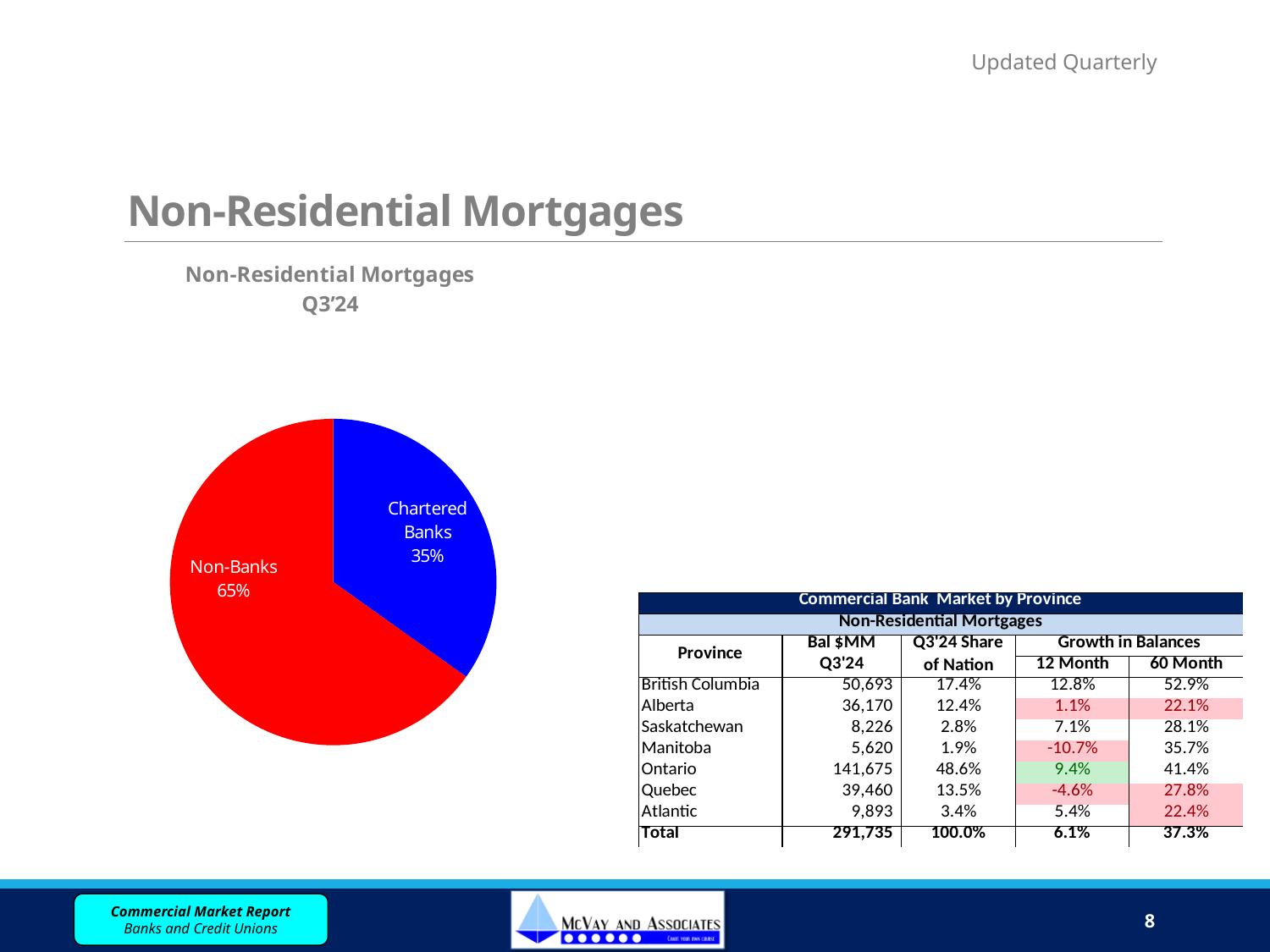
Which slice of the pie chart is the largest? Non-Banks How many slices does the pie chart have? 2 Is the Chartered Banks share of the pie chart greater or less than 50%? less What colour is the Non-Banks slice of the pie chart? red What kind of chart is shown on the slide? pie chart What is the difference in percentage points between the Non-Banks and Chartered Banks slices? 30 What share of the pie chart is Non-Banks? 65% Which slice of the pie chart is the smallest? Chartered Banks What share of the pie chart is Chartered Banks? 35% What is the title of the pie chart? Non-Residential Mortgages Q3'24 Which is larger in the pie chart, Non-Banks or Chartered Banks? Non-Banks